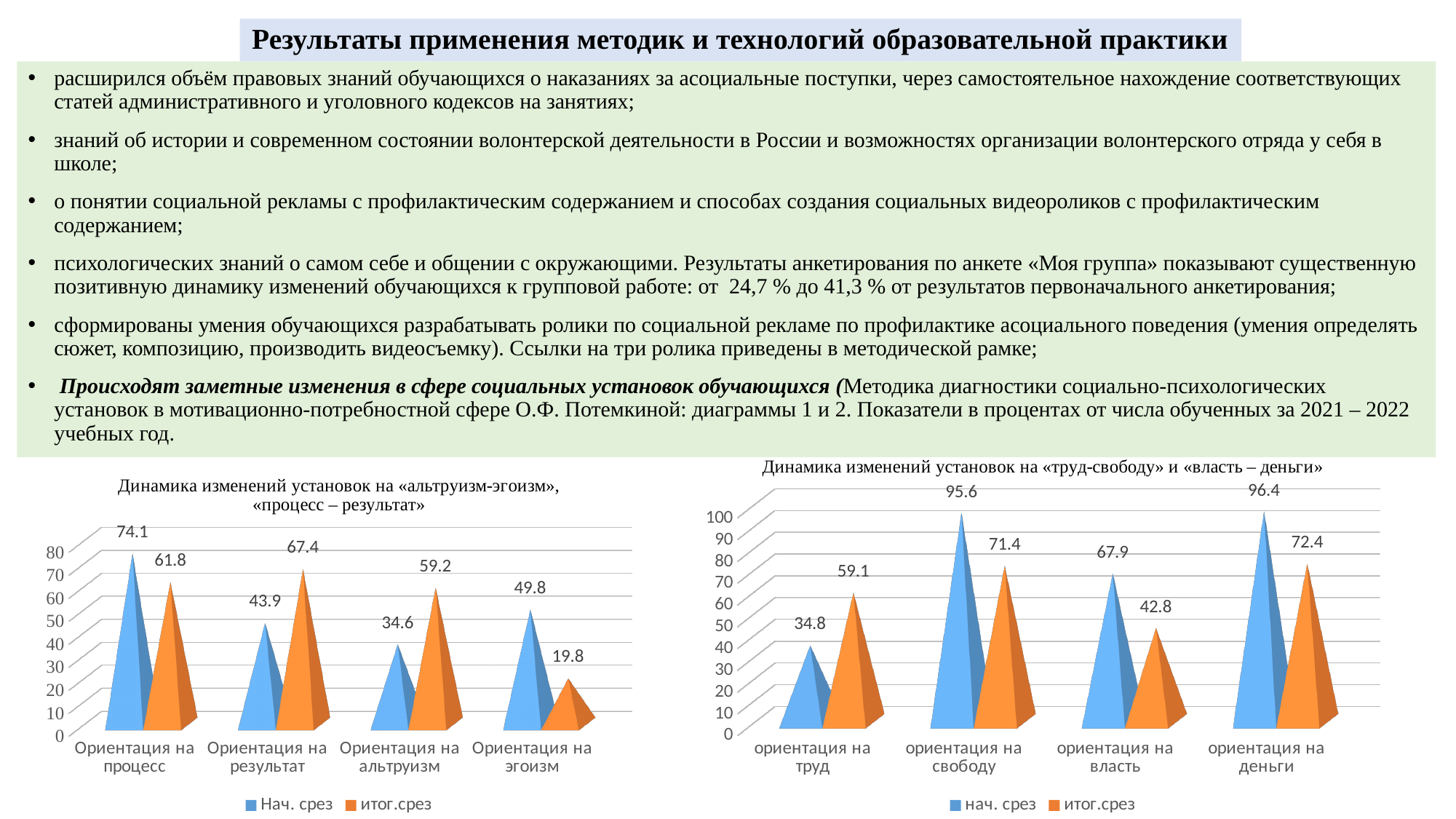
In the left chart («альтруизм-эгоизм», «процесс – результат»), what is the value of «Нач. срез» for «Ориентация на процесс»? 74.1 In the right chart («труд-свободу» и «власть – деньги»), which category has the lowest «нач. срез» value? ориентация на труд In the left chart («альтруизм-эгоизм», «процесс – результат»), what is the value of «итог.срез» for «Ориентация на эгоизм»? 19.8 What type of chart is the left chart («альтруизм-эгоизм», «процесс – результат»)? Bar chart In the right chart («труд-свободу» и «власть – деньги»), which is larger for «ориентация на деньги»: «нач. срез» or «итог.срез»? нач. срез In the right chart («труд-свободу» и «власть – деньги»), what is the difference between «итог.срез» and «нач. срез» for «ориентация на труд»? 24.3 How many series does the legend of the right chart («труд-свободу» и «власть – деньги») list? 2 In the right chart («труд-свободу» и «власть – деньги»), what is the value of «итог.срез» for «ориентация на власть»? 42.8 In the left chart («альтруизм-эгоизм», «процесс – результат»), how many categories are shown on the x axis? 4 In the left chart («альтруизм-эгоизм», «процесс – результат»), what is the difference between «итог.срез» and «Нач. срез» for «Ориентация на альтруизм»? 24.6 In the left chart («альтруизм-эгоизм», «процесс – результат»), which category has the highest «итог.срез» value? Ориентация на результат In the right chart («труд-свободу» и «власть – деньги»), what is the value of «нач. срез» for «ориентация на свободу»? 95.6